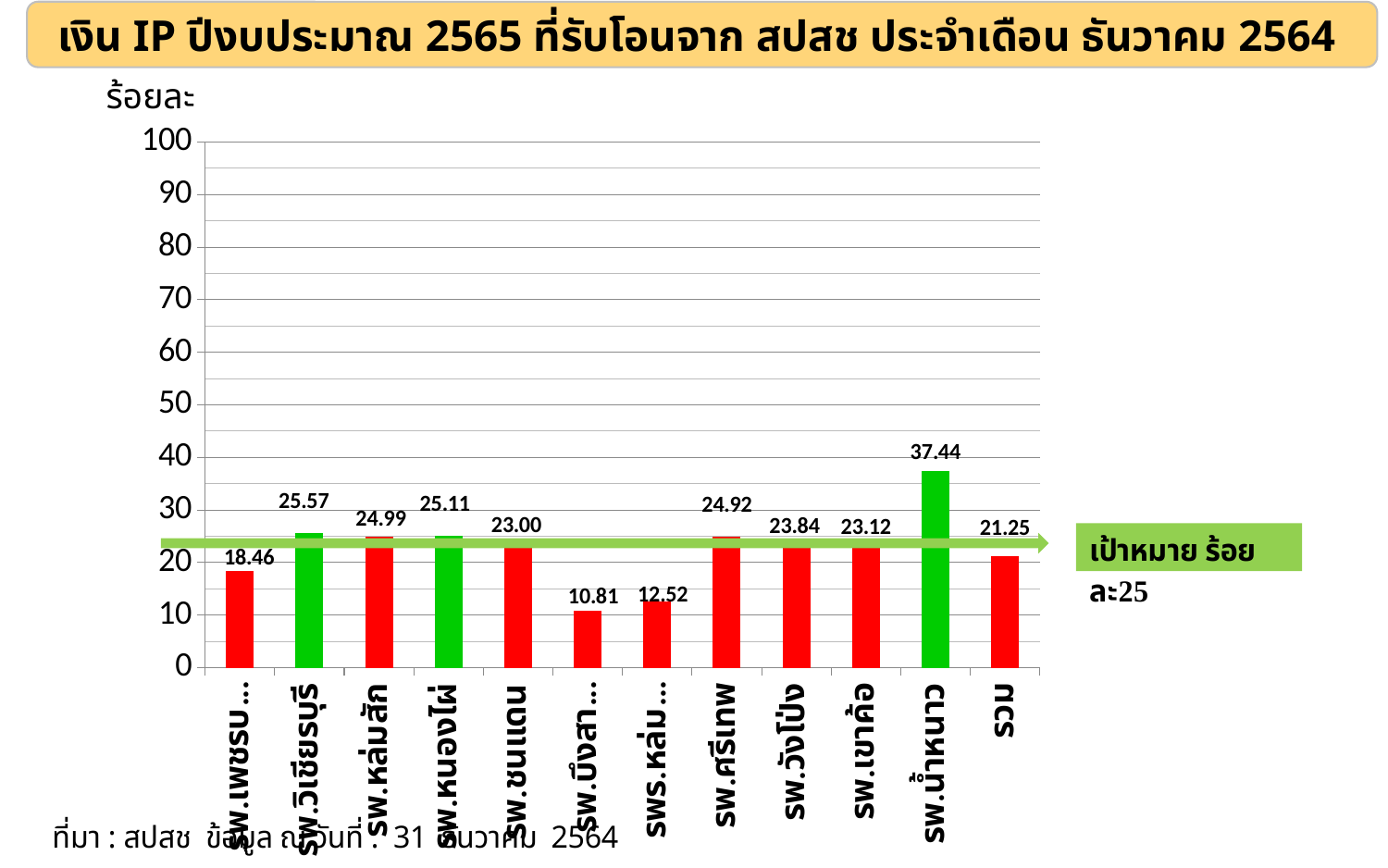
What is the lowest value shown in the chart? 10.81 How many bars (categories) are plotted in the chart? 12 Is the value for รพ.หล่มสัก greater or less than 30? less What target value is indicated by the green horizontal line label? เป้าหมาย ร้อยละ25 What is the value for รพ.น้ำหนาว? 37.44 What is the value for รพ.วิเชียรบุรี? 25.57 Which is larger, the value for รพ.ศรีเทพ or รพ.วังโป่ง? รพ.ศรีเทพ What is the value for รพ.ชนแดน? 23.00 What type of chart is shown on the slide? bar chart Which category has the highest value? รพ.น้ำหนาว